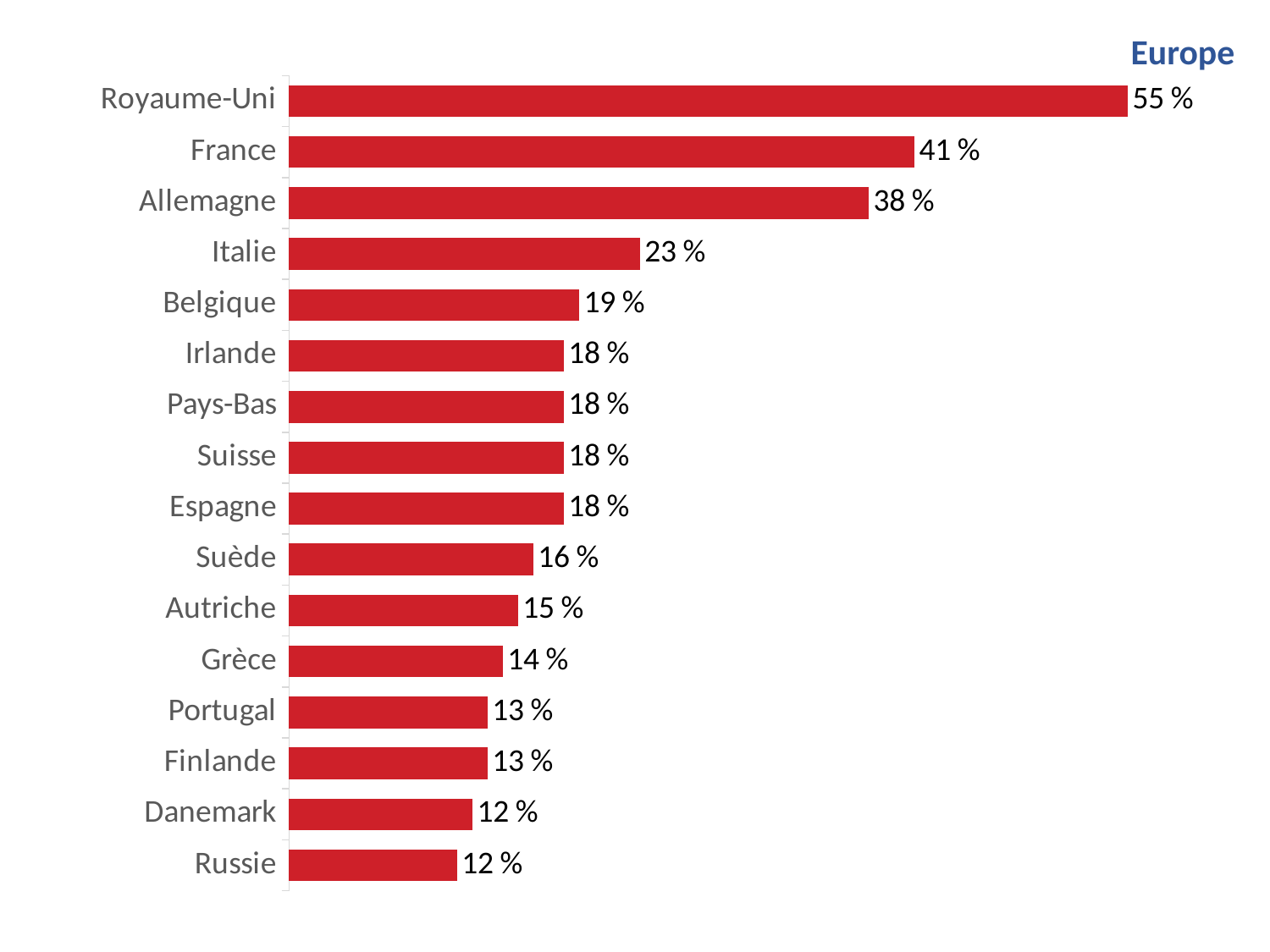
What kind of chart is shown on the slide? Bar chart Which country has the highest value? Royaume-Uni What is the value for Grèce? 14 % What is the difference between the values for Royaume-Uni and Allemagne? 17 % Which is larger, the value for Autriche or the value for Portugal? Autriche What is the value for Belgique? 19 % What is the title of the chart? Europe What colour are the bars in the chart? Red How many countries are shown in the chart? 16 Which is larger, the value for France or the value for Allemagne? France What is the value for France? 41 % What is the difference between the values for Italie and Suède? 7 %